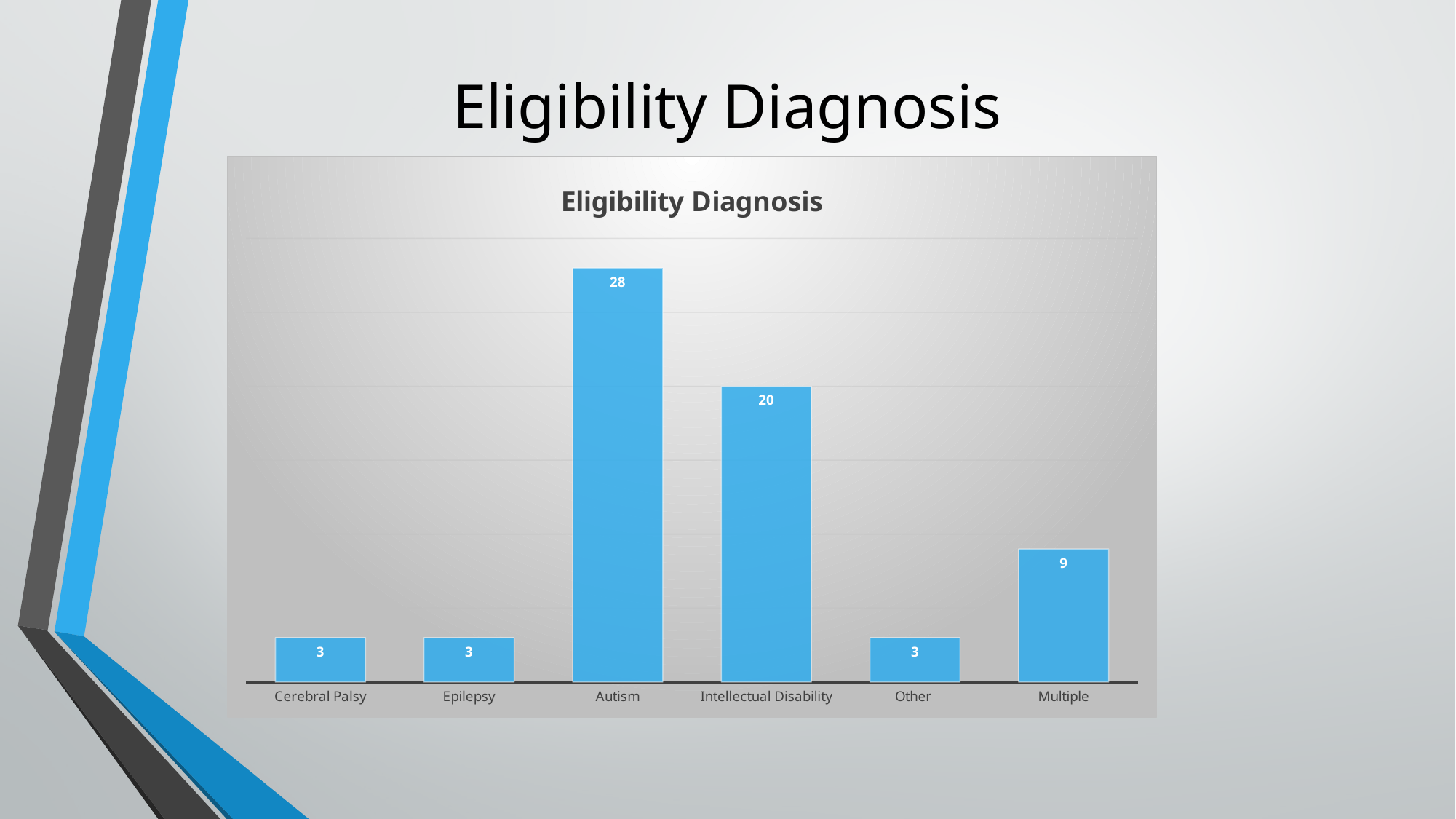
What is the difference between the values for Autism and Intellectual Disability? 8 How many categories are shown on the x axis? 6 What kind of chart is shown? Bar chart How many categories have a value of 3? 3 Which is larger, the value for Intellectual Disability or the value for Multiple? Intellectual Disability What is the title of the chart? Eligibility Diagnosis What is the value for Epilepsy? 3 Which category has the highest value? Autism What is the difference between the values for Multiple and Other? 6 What is the value for Autism? 28 What is the value for Multiple? 9 What is the value for Intellectual Disability? 20